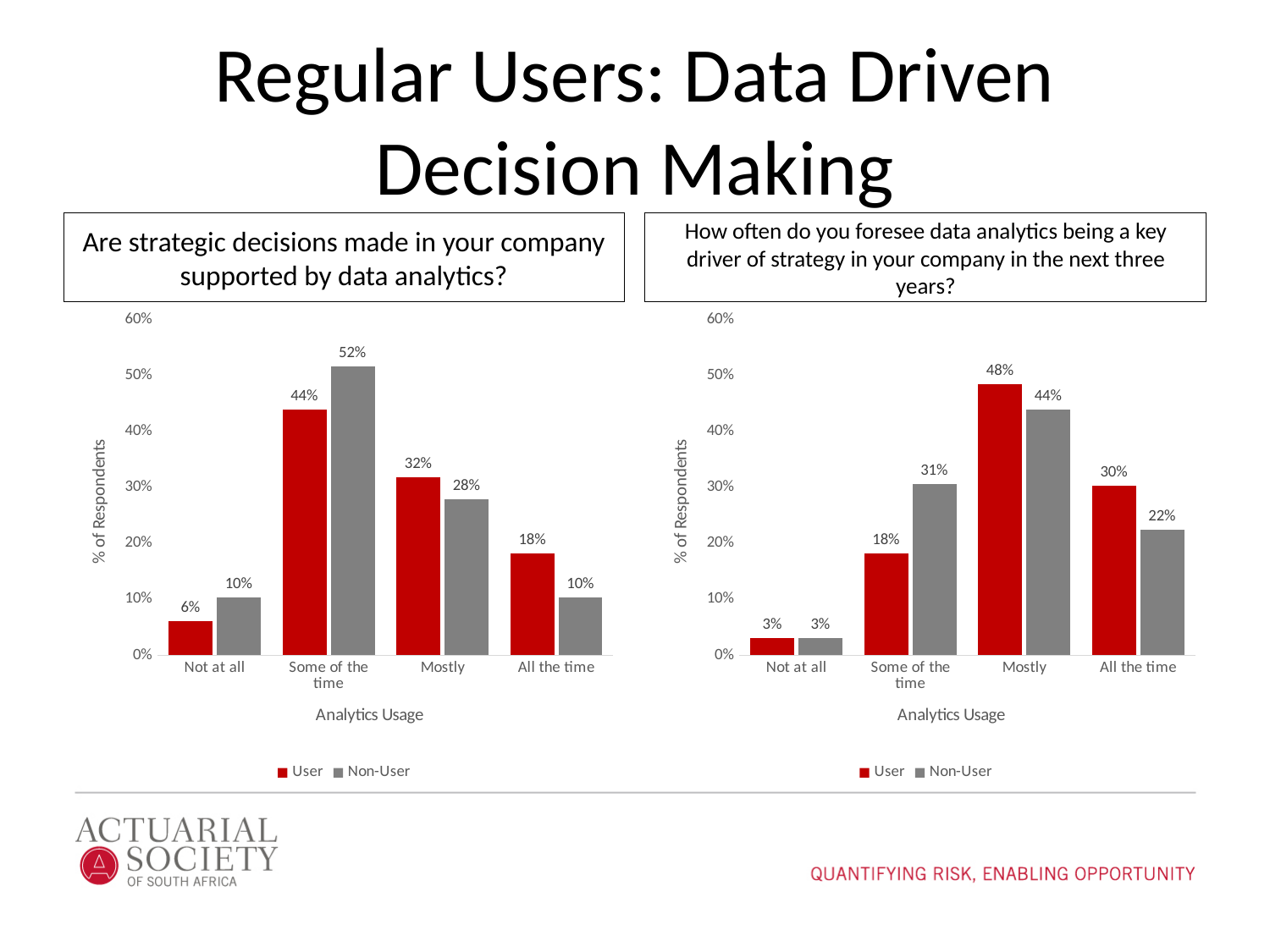
How many series does the legend of the left chart (Are strategic decisions made in your company supported by data analytics?) list? 2 In the right chart (How often do you foresee data analytics being a key driver of strategy in your company in the next three years?), which category has the highest Non-User value? Mostly In the left chart (Are strategic decisions made in your company supported by data analytics?), what is the difference between the Non-User and User values for 'Some of the time'? 8% In the right chart (How often do you foresee data analytics being a key driver of strategy in your company in the next three years?), which is larger for 'Some of the time': User or Non-User? Non-User In the left chart (Are strategic decisions made in your company supported by data analytics?), what is the value for Non-User in the 'Mostly' category? 28% In the right chart (How often do you foresee data analytics being a key driver of strategy in your company in the next three years?), what is the difference between the User and Non-User values for 'All the time'? 8% In the left chart (Are strategic decisions made in your company supported by data analytics?), which category has the lowest User value? Not at all How many categories are shown on the x axis of the right chart (How often do you foresee data analytics being a key driver of strategy in your company in the next three years?)? 4 In the left chart (Are strategic decisions made in your company supported by data analytics?), is the Non-User value for 'Some of the time' greater or less than 50%? greater What type of chart is the right chart (How often do you foresee data analytics being a key driver of strategy in your company in the next three years?)? Bar chart In the left chart (Are strategic decisions made in your company supported by data analytics?), what is the value for User in the 'Some of the time' category? 44% In the right chart (How often do you foresee data analytics being a key driver of strategy in your company in the next three years?), what is the value for User in the 'All the time' category? 30%